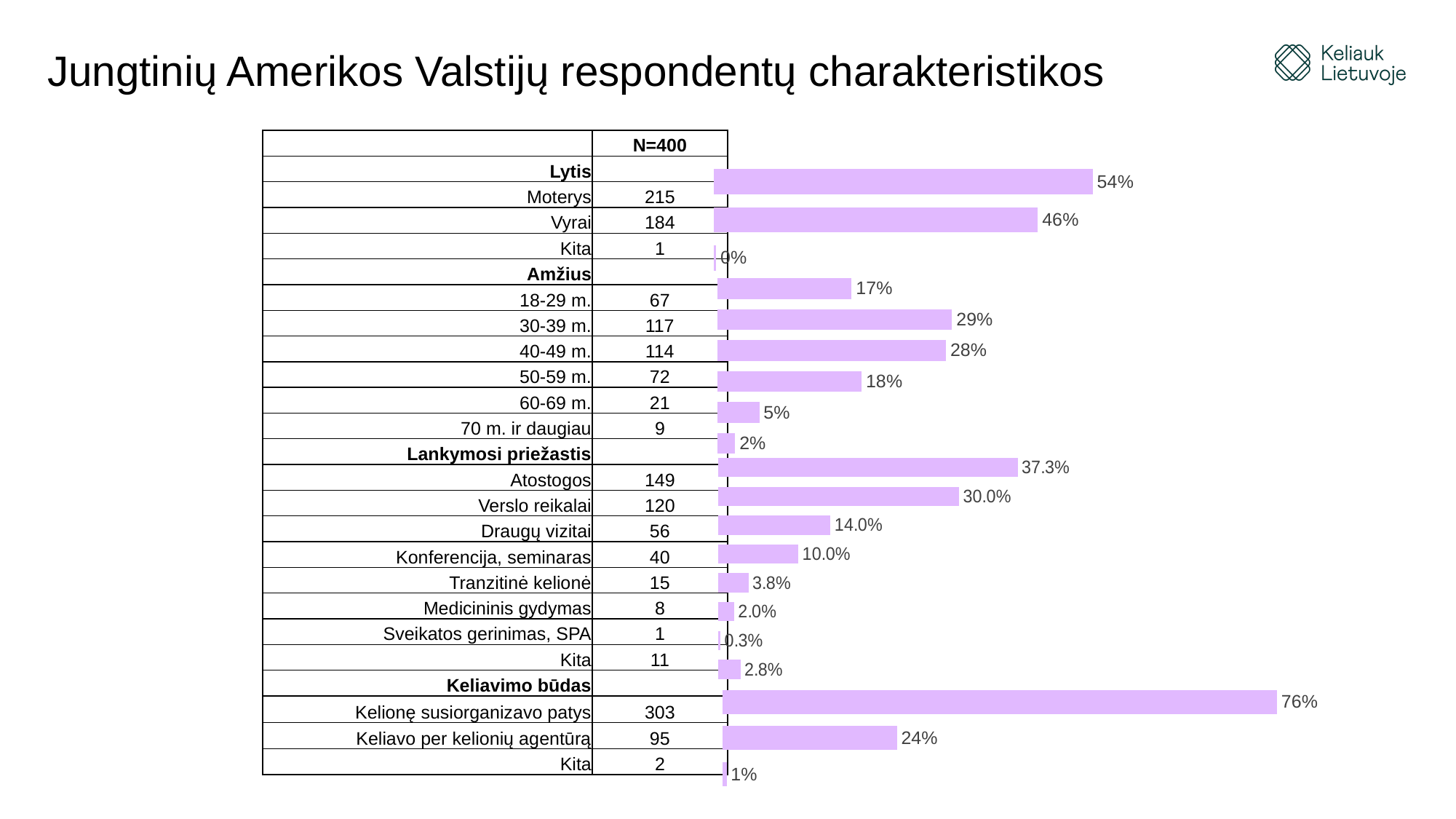
Which visit reason (Lankymosi priežastis) has the lowest percentage? Sveikatos gerinimas, SPA What percentage is shown for Verslo reikalai under Lankymosi priežastis? 30.0% What is the difference in percentage points between Atostogos and Verslo reikalai? 7.3 What kind of chart is used to show the percentages on the slide? Bar chart What is the total number of respondents (N) shown in the table header? N=400 What is the difference in percentage points between Moterys and Vyrai? 8 What percentage is shown for Keliavo per kelionių agentūrą? 24% How many age groups are listed in the Amžius section? 6 Which age group has the highest percentage? 30-39 m. Which is larger, the percentage for 50-59 m. or for 18-29 m.? 50-59 m. What percentage is shown for Moterys in the Lytis section? 54% What percentage is shown for the 30-39 m. age group? 29%